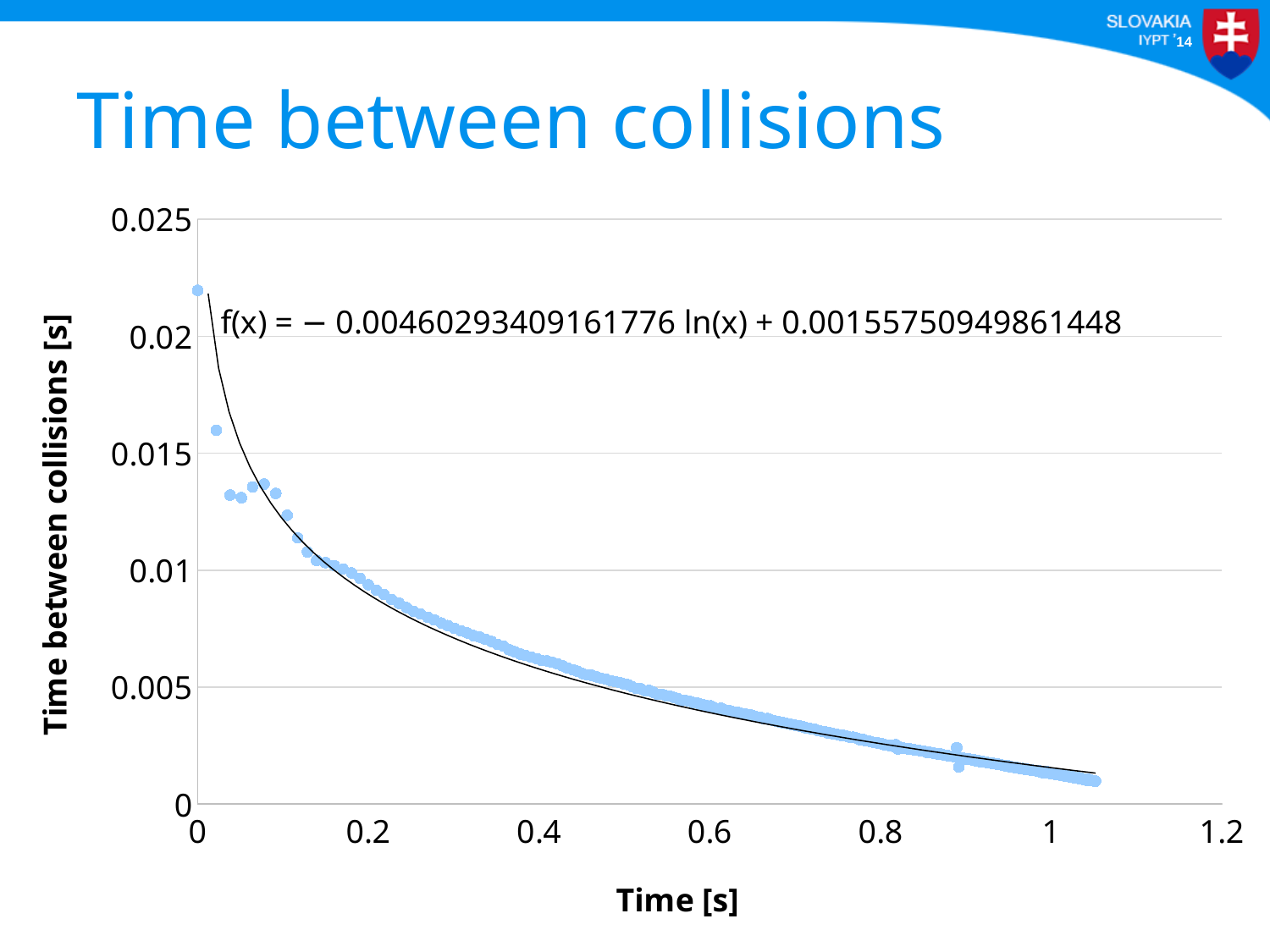
Is the time between collisions at Time 0.8 greater or less than 0.005? less Which has a larger time between collisions: Time 0.2 or Time 0.8? Time 0.2 What fitted function f(x) is displayed on the chart? f(x) = − 0.00460293409161776 ln(x) + 0.00155750949861448 What is the label of the x axis? Time [s] Is the time between collisions at Time 0.4 greater or less than 0.01? less What kind of chart is shown on the slide? Scatter chart Do the plotted values rise or fall as Time increases along the x axis? Fall Is the time between collisions at Time 1 greater or less than 0.005? less